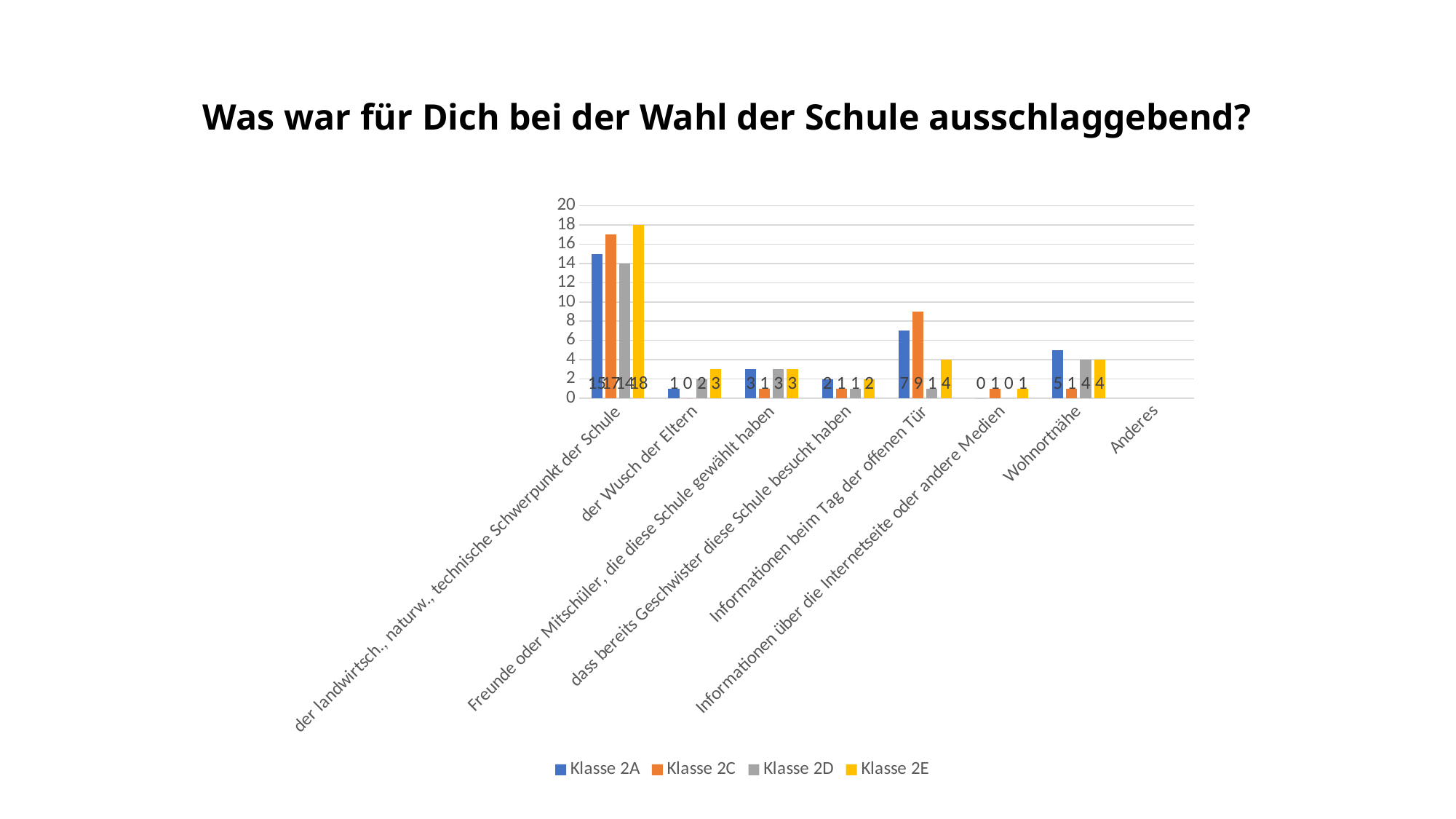
What is the value for Klasse 2A in the category "Wohnortnähe"? 5 Which category has the highest value for Klasse 2E? der landwirtsch., naturw., technische Schwerpunkt der Schule How many series does the legend list? 4 What is the value for Klasse 2C in the category "Informationen beim Tag der offenen Tür"? 9 What is the value for Klasse 2E in the category "der Wusch der Eltern"? 3 In the category "Informationen beim Tag der offenen Tür", which is larger: Klasse 2A or Klasse 2C? Klasse 2C How many categories are shown on the x axis? 8 What is the value for Klasse 2E in the category "der landwirtsch., naturw., technische Schwerpunkt der Schule"? 18 In the category "Informationen beim Tag der offenen Tür", what is the difference between Klasse 2C and Klasse 2D? 8 What kind of chart is shown on the slide? bar chart What is the value for Klasse 2C in the category "Informationen über die Internetseite oder andere Medien"? 1 Is the value for Klasse 2C in the category "der landwirtsch., naturw., technische Schwerpunkt der Schule" greater or less than 16? greater